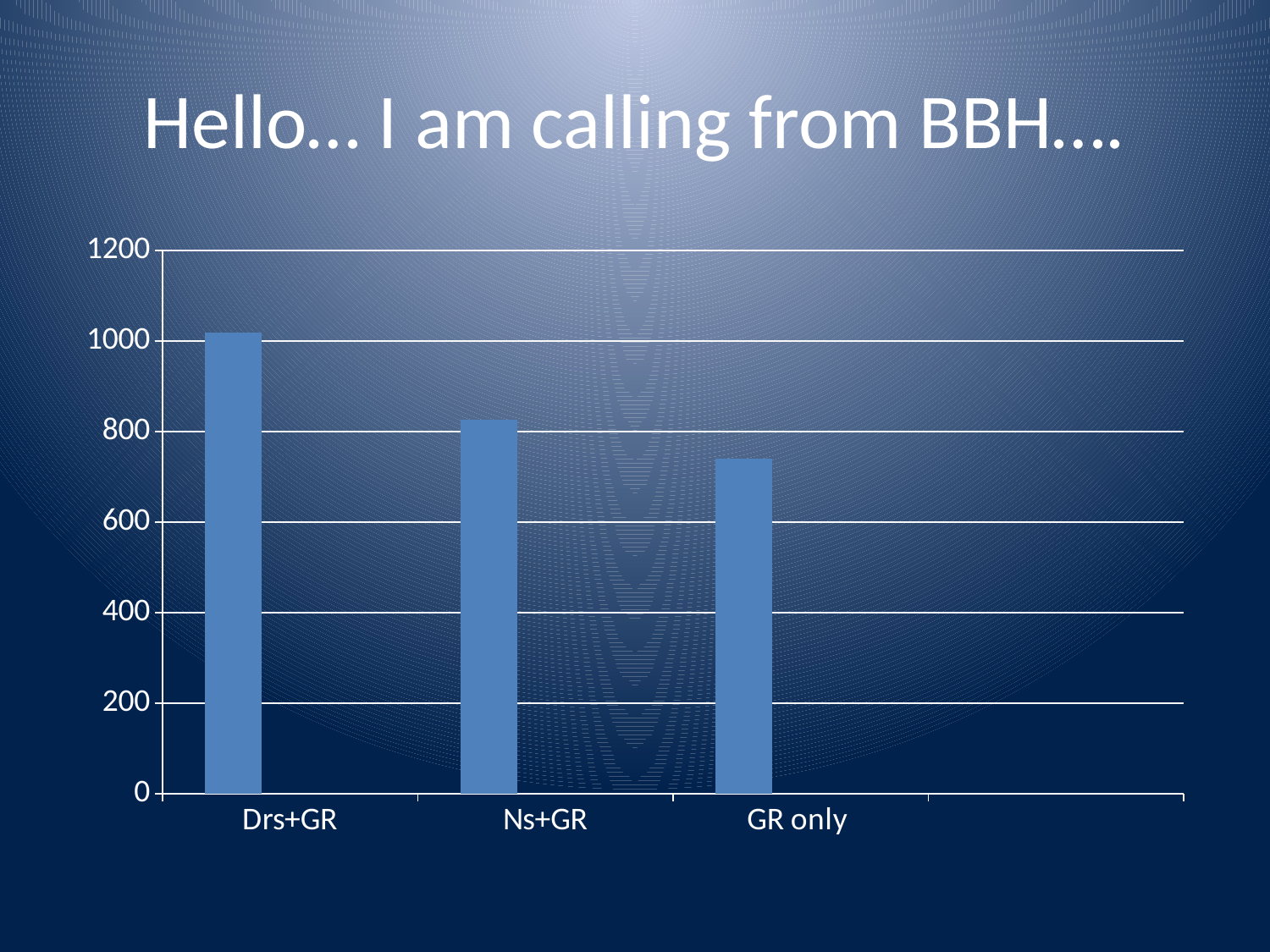
Is the value for Drs+GR greater or less than 800? greater Is the value for Ns+GR greater or less than 1000? less Do the bar values rise or fall from left to right across the categories? fall Is the value for GR only greater or less than 800? less Which category has the lowest bar? GR only What kind of chart is shown on the slide? bar chart What is the title of the slide containing the chart? Hello… I am calling from BBH…. How many categories are plotted in the chart? 3 Which is larger, the value for Ns+GR or the value for GR only? Ns+GR Which is larger, the value for Drs+GR or the value for Ns+GR? Drs+GR Which category has the highest bar? Drs+GR